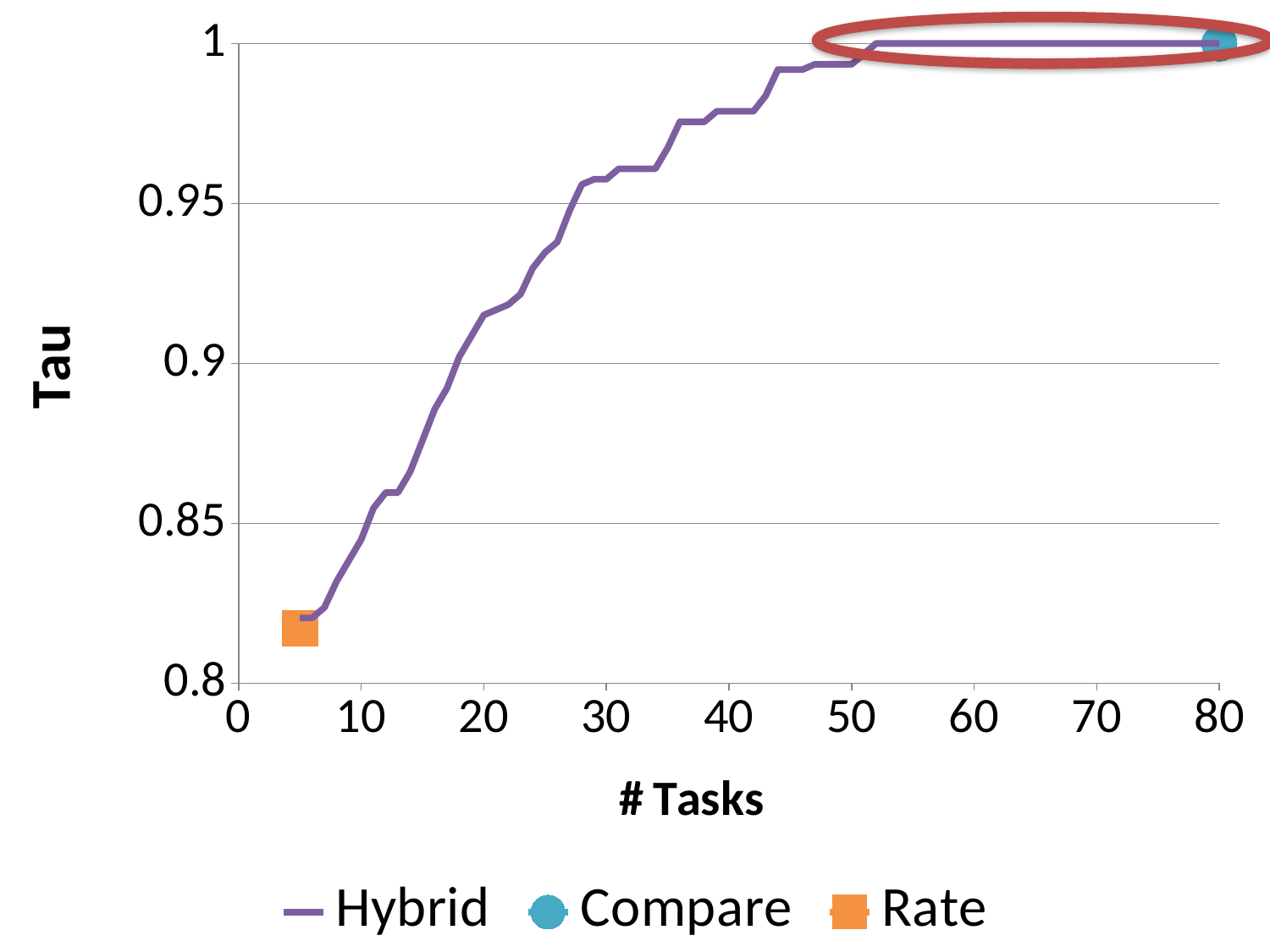
How many series does the legend list? 3 Does the Hybrid line rise or fall as the number of tasks increases? rise Is the Hybrid line's Tau value at 20 tasks greater or less than 0.9? greater Which has the higher Tau value, the Compare point or the Rate point? Compare What are the three series named in the legend? Hybrid, Compare, Rate What Tau value does the Compare point reach? 1 What kind of chart is shown on the slide? line chart What is the label of the y axis? Tau Is the Tau value for the Rate point greater or less than 0.85? less Is the Hybrid line's Tau value at 40 tasks greater or less than 0.95? greater